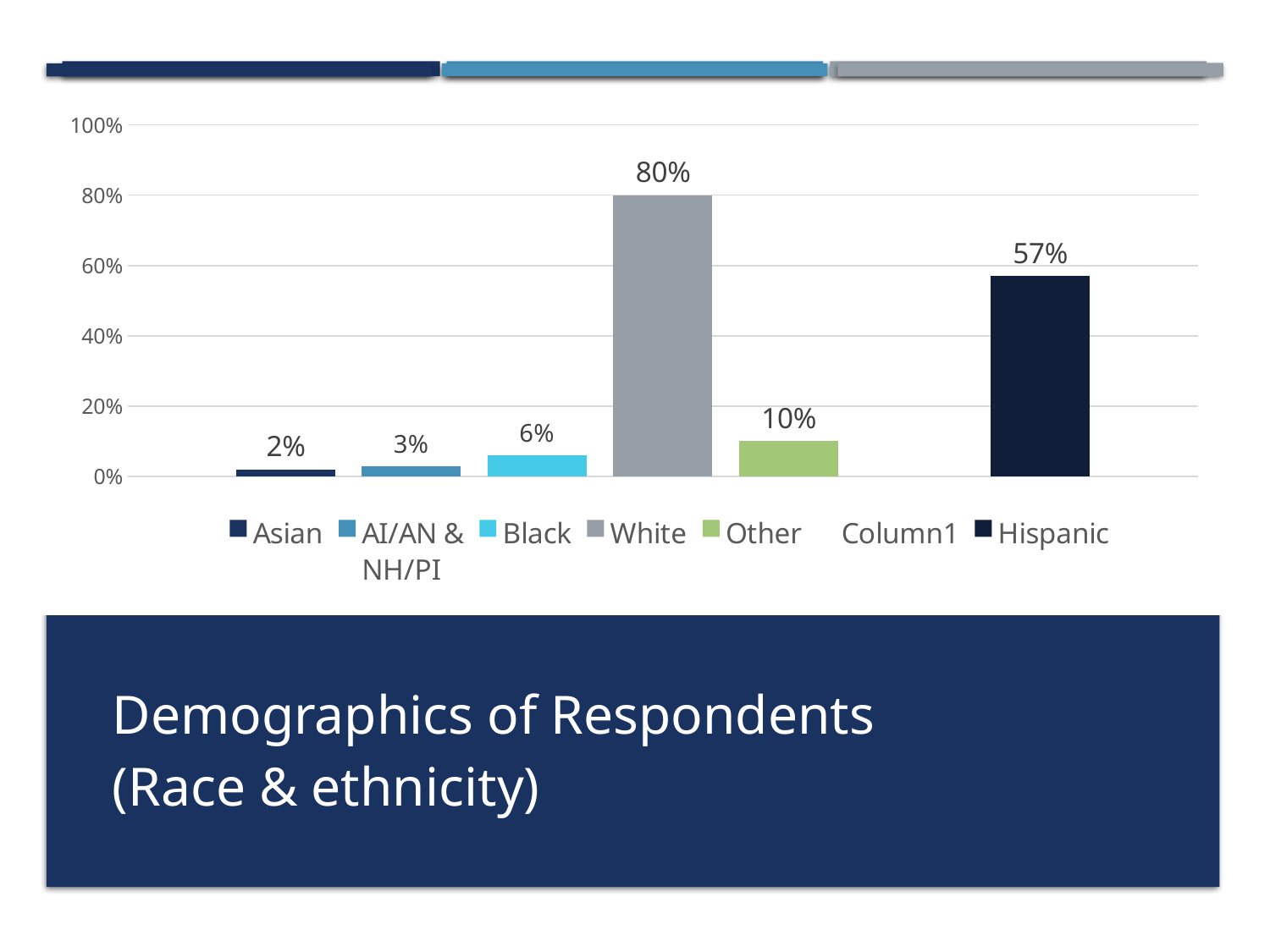
What is the title shown in the box below the chart? Demographics of Respondents (Race & ethnicity) Which group has the highest percentage of respondents? White What percentage of respondents are AI/AN & NH/PI? 3% What percentage of respondents are Hispanic? 57% What is the difference between the White and Hispanic percentages? 23% How many entries does the legend list? 7 Which is larger, the percentage for Other or the percentage for Black? Other Which group has the lowest percentage of respondents? Asian What percentage of respondents are Black? 6% What kind of chart is shown on the slide? Bar chart What percentage of respondents are White? 80% What is the difference between the Other and Asian percentages? 8%